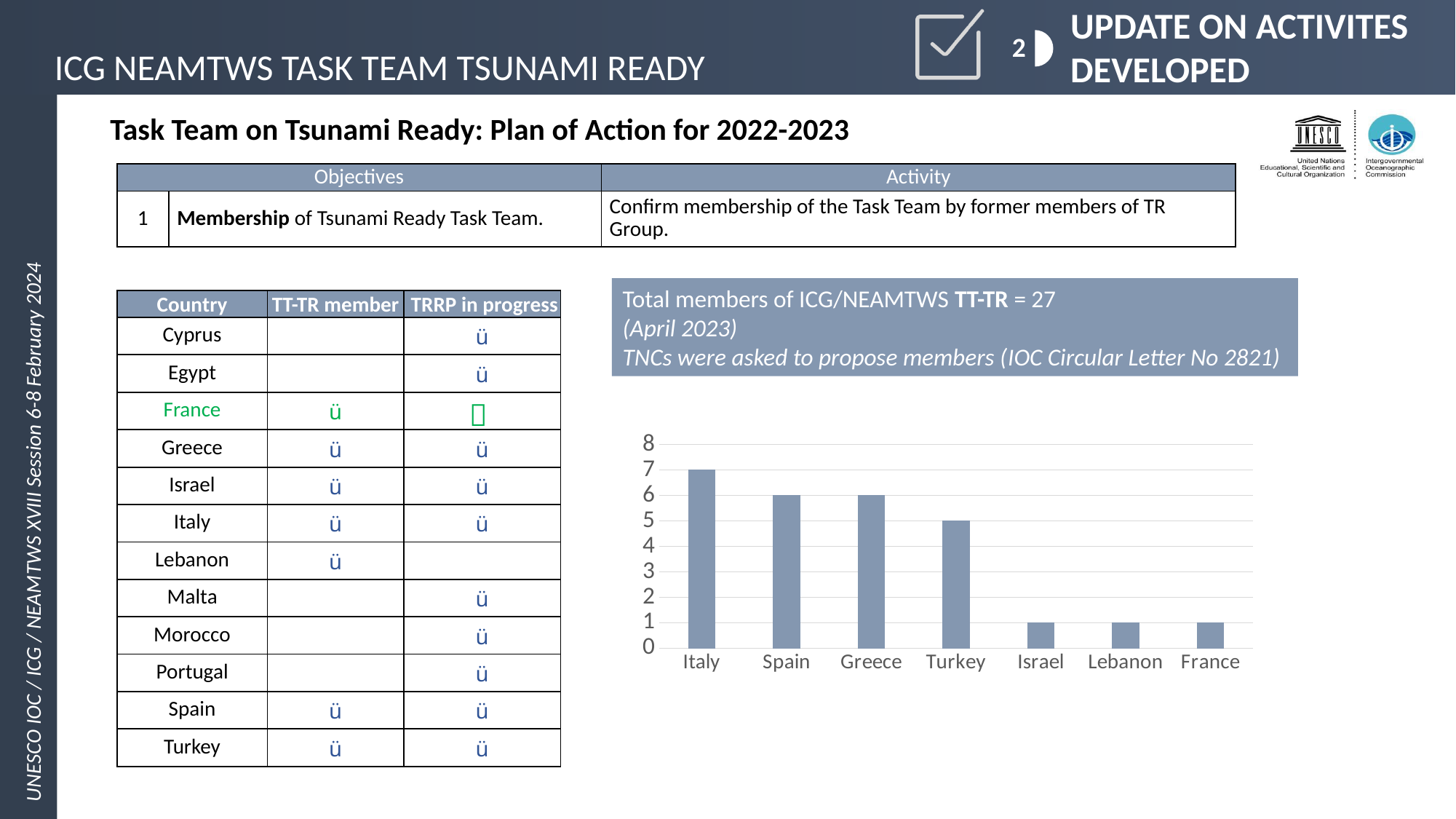
How many countries are shown on the x axis of the bar chart? 7 What is the difference between the bar for Italy and the bar for Turkey? 2 What is the value of the bar for Spain? 6 Which is larger, the bar for Greece or the bar for Turkey? Greece What is the value of the bar for France? 1 What is the value of the bar for Italy? 7 Which country has the highest bar in the chart? Italy Is the value for Lebanon greater or less than 3? less What is the highest value shown on the y axis of the chart? 8 Is the value for Spain greater or less than 4? greater What kind of chart is shown on the slide? bar chart What is the value of the bar for Turkey? 5